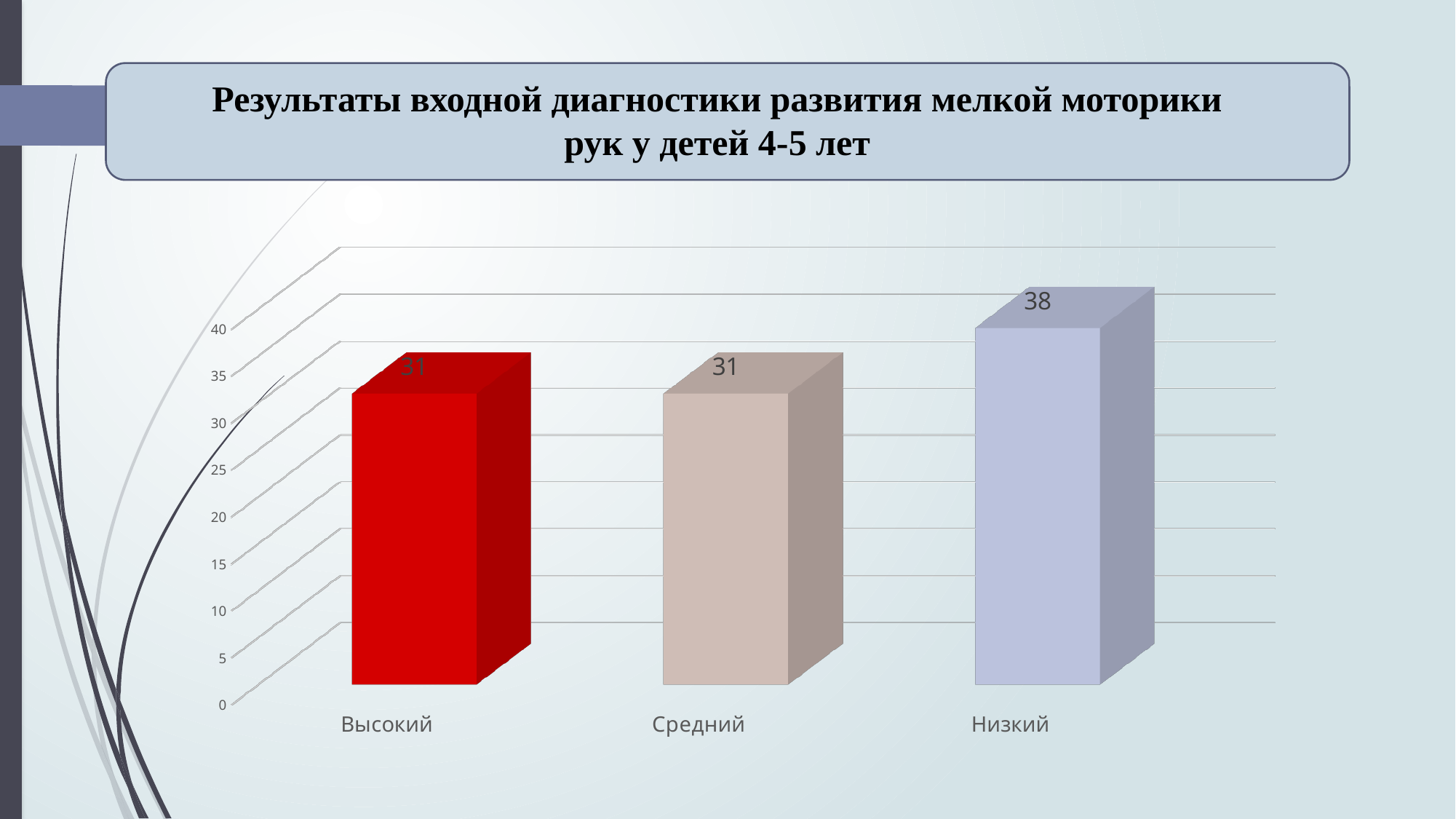
What is the difference between the values for Низкий and Высокий? 7 How many categories are shown on the chart? 3 What colour is the bar for Высокий? red Which is larger, the value for Низкий or the value for Средний? Низкий What is the value for Средний? 31 What kind of chart is shown on the slide? bar chart What is the total of the three values shown on the chart? 100 What is the value for Низкий? 38 Is the value for Средний greater or less than 35? less Which category has the highest value? Низкий Is the value for Низкий greater or less than 35? greater What is the value for Высокий? 31